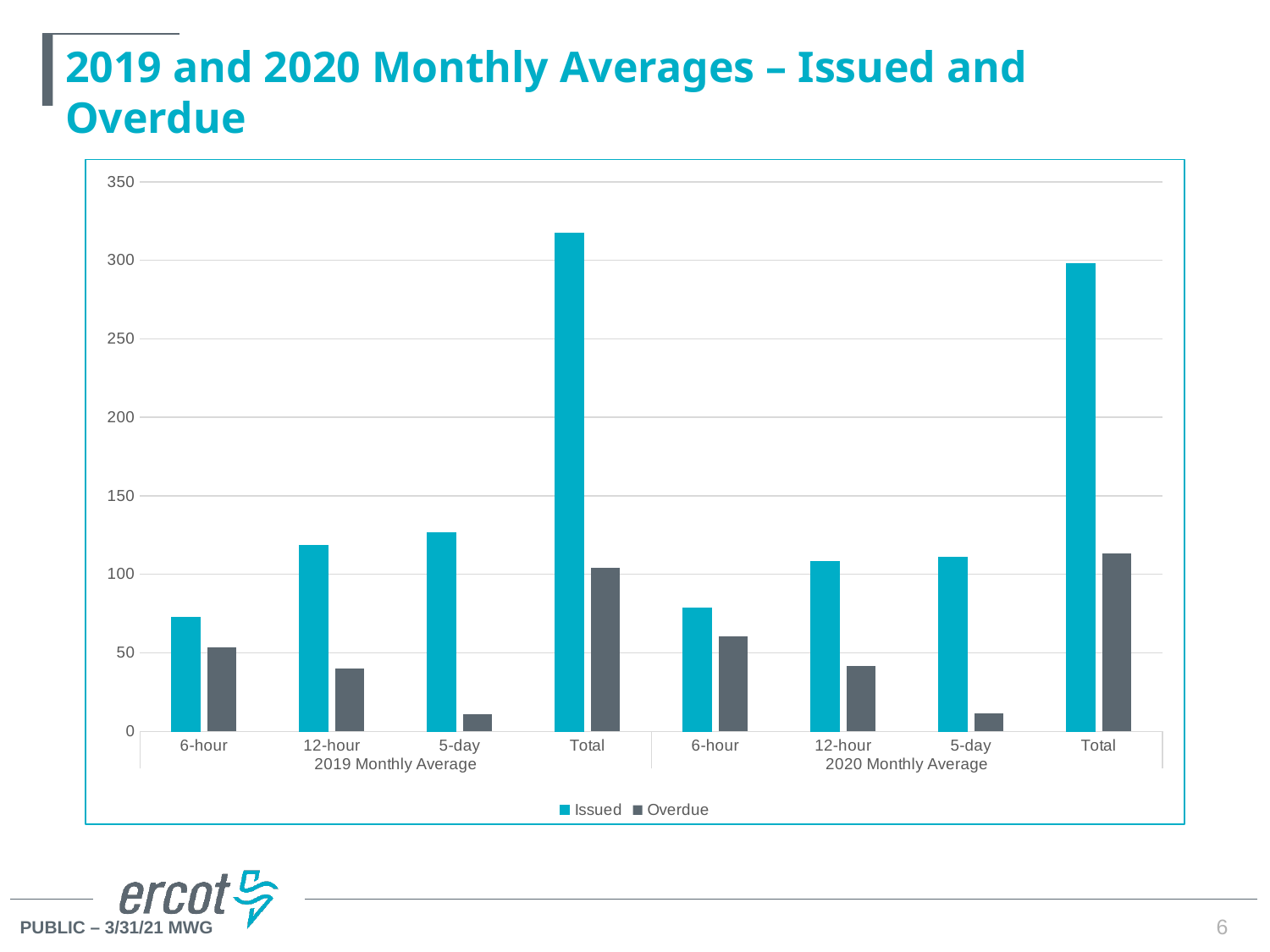
How many series does the legend list? 2 Is the Overdue value for Total in the 2020 Monthly Average group greater or less than 100? greater Is the Issued value for 6-hour in the 2019 Monthly Average group greater or less than 100? less Which category has the highest Issued bar? Total (2019 Monthly Average) Within the 2019 Monthly Average group, which category has the lowest Overdue bar? 5-day Is the Overdue value for 5-day in the 2019 Monthly Average group greater or less than 50? less Which is larger: the Issued value for Total in 2019 Monthly Average or the Issued value for Total in 2020 Monthly Average? Total in 2019 Monthly Average What colour are the Issued bars in the chart? Teal (cyan) Which is larger: the Issued value for 12-hour in 2019 Monthly Average or the Issued value for 12-hour in 2020 Monthly Average? 12-hour in 2019 Monthly Average How many categories are shown along the x axis in total? 8 What kind of chart is shown on the slide? Bar chart